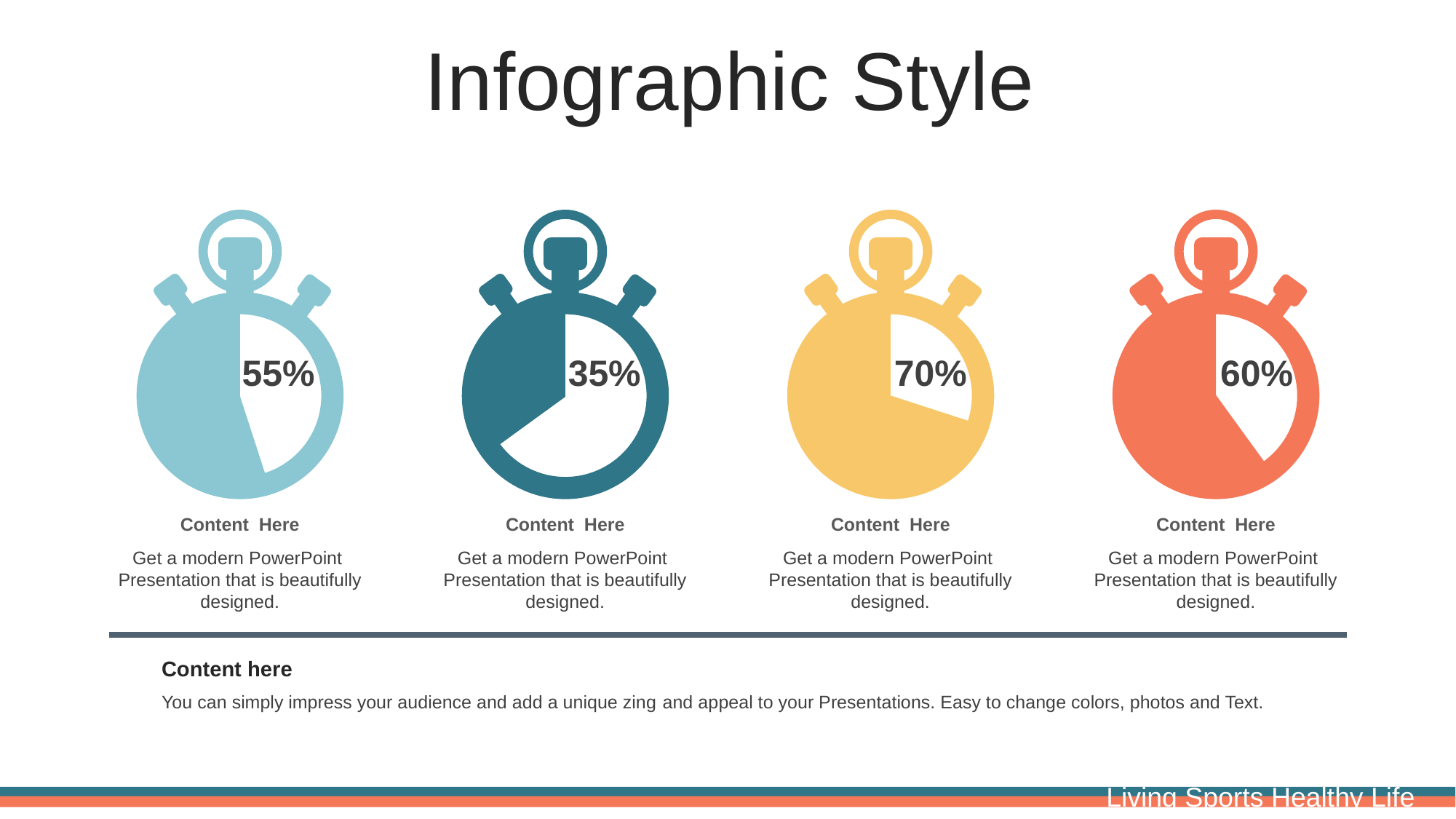
What percentage is shown on the leftmost (light blue) stopwatch? 55% How many stopwatch charts are shown on the slide? 4 Which stopwatch shows the highest percentage? The third (yellow) stopwatch, 70% What percentage is shown on the third (yellow) stopwatch from the left? 70% What colour is the stopwatch that shows 70%? Yellow What percentage is shown on the second (dark teal) stopwatch from the left? 35% What is the difference between the percentage on the orange stopwatch and the percentage on the light blue stopwatch? 5% Which stopwatch shows the lowest percentage? The second (dark teal) stopwatch, 35% What is the difference between the percentage on the yellow stopwatch and the percentage on the dark teal stopwatch? 35% What percentage is shown on the rightmost (orange) stopwatch? 60% Which shows a larger percentage, the light blue stopwatch or the orange stopwatch? The orange stopwatch What is the title of the slide? Infographic Style